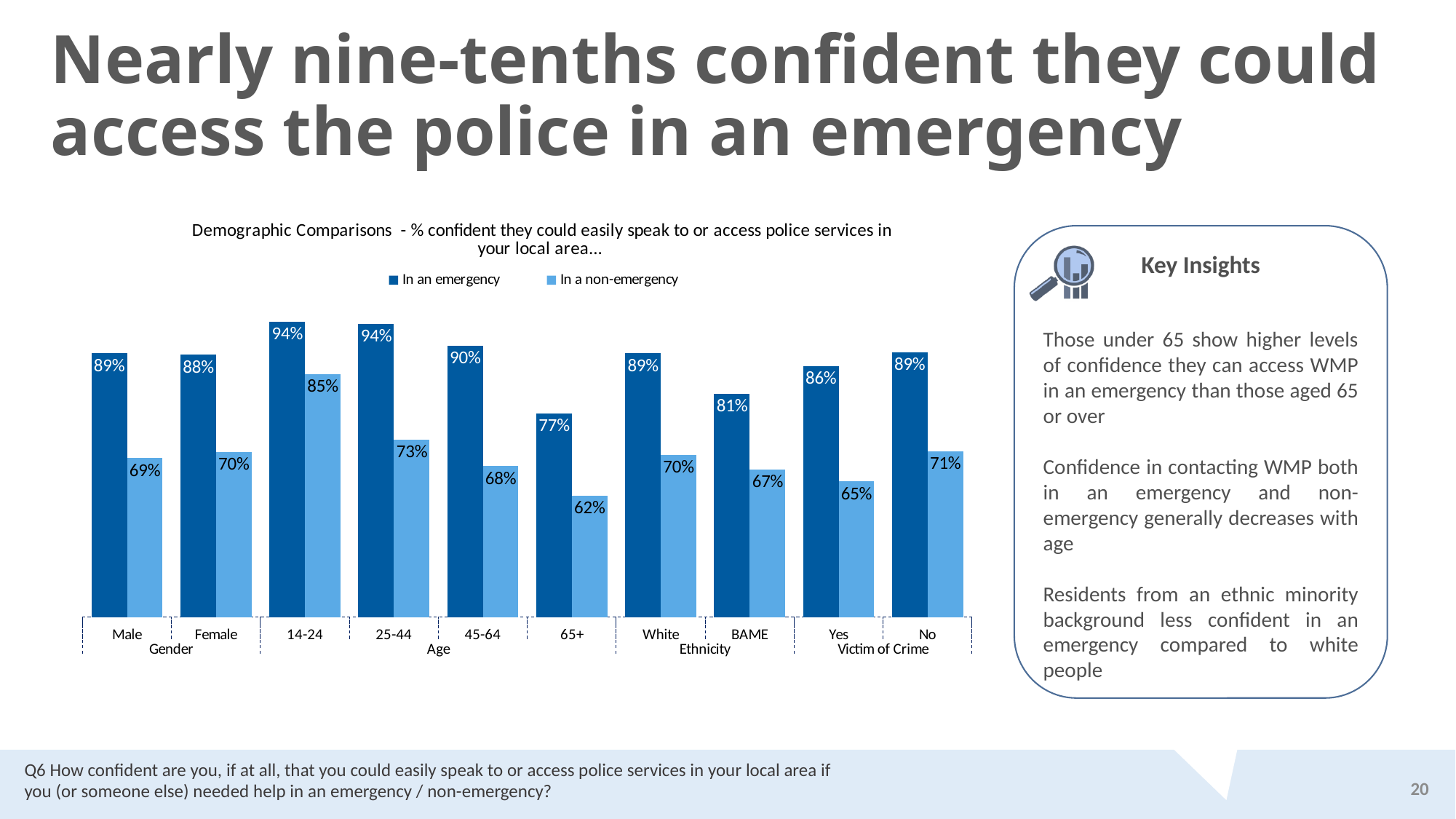
Which is larger: the 'In an emergency' value for Yes (Victim of Crime) or for No? No What kind of chart is shown on the slide? Bar chart Which category has the highest value in the 'In a non-emergency' series? 14-24 What is the difference between the 'In an emergency' and 'In a non-emergency' values for White? 19 percentage points Which category has the lowest value in the 'In an emergency' series? 65+ What are the two series named in the legend? In an emergency; In a non-emergency How many categories are shown on the x axis? 10 Do the 'In an emergency' values rise or fall across the age groups from 14-24 to 65+? Fall What is the value for Male in the 'In an emergency' series? 89% What is the value for 65+ in the 'In a non-emergency' series? 62% What is the value for BAME in the 'In an emergency' series? 81% How many series does the legend list? 2